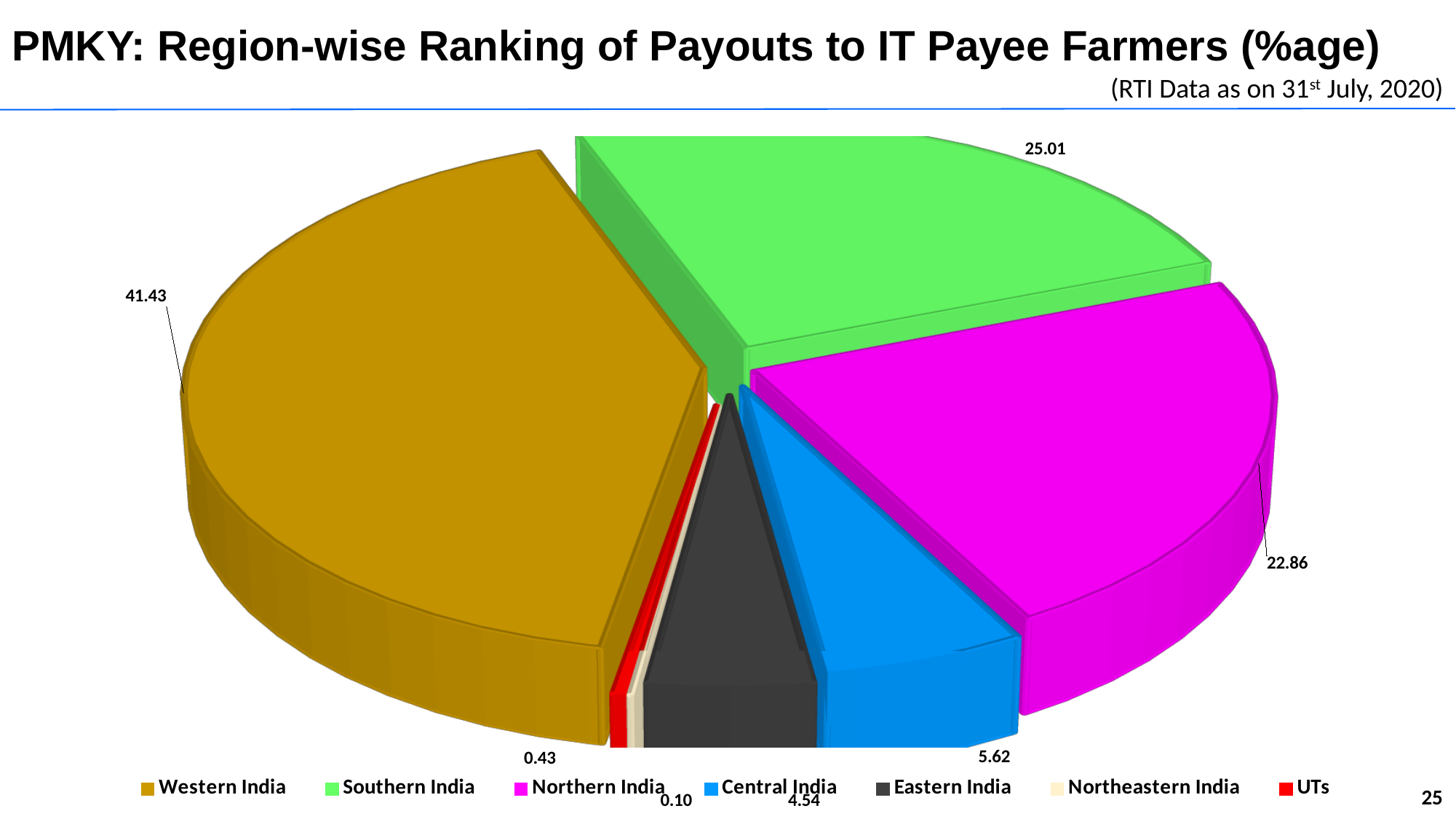
What is the value for Eastern India? 4.54 What kind of chart is shown on the slide? Pie chart What is the value for Northern India? 22.86 What is the value for Southern India? 25.01 What is the difference between the values for Western India and Southern India? 16.42 How many regions are shown in the legend? 7 What is the value for Central India? 5.62 What is the value for Western India? 41.43 What colour represents Northern India in the pie chart? Magenta Which is larger, the value for Central India or Eastern India? Central India Which region has the largest share of the pie? Western India Which region has the smallest share of the pie? Northeastern India